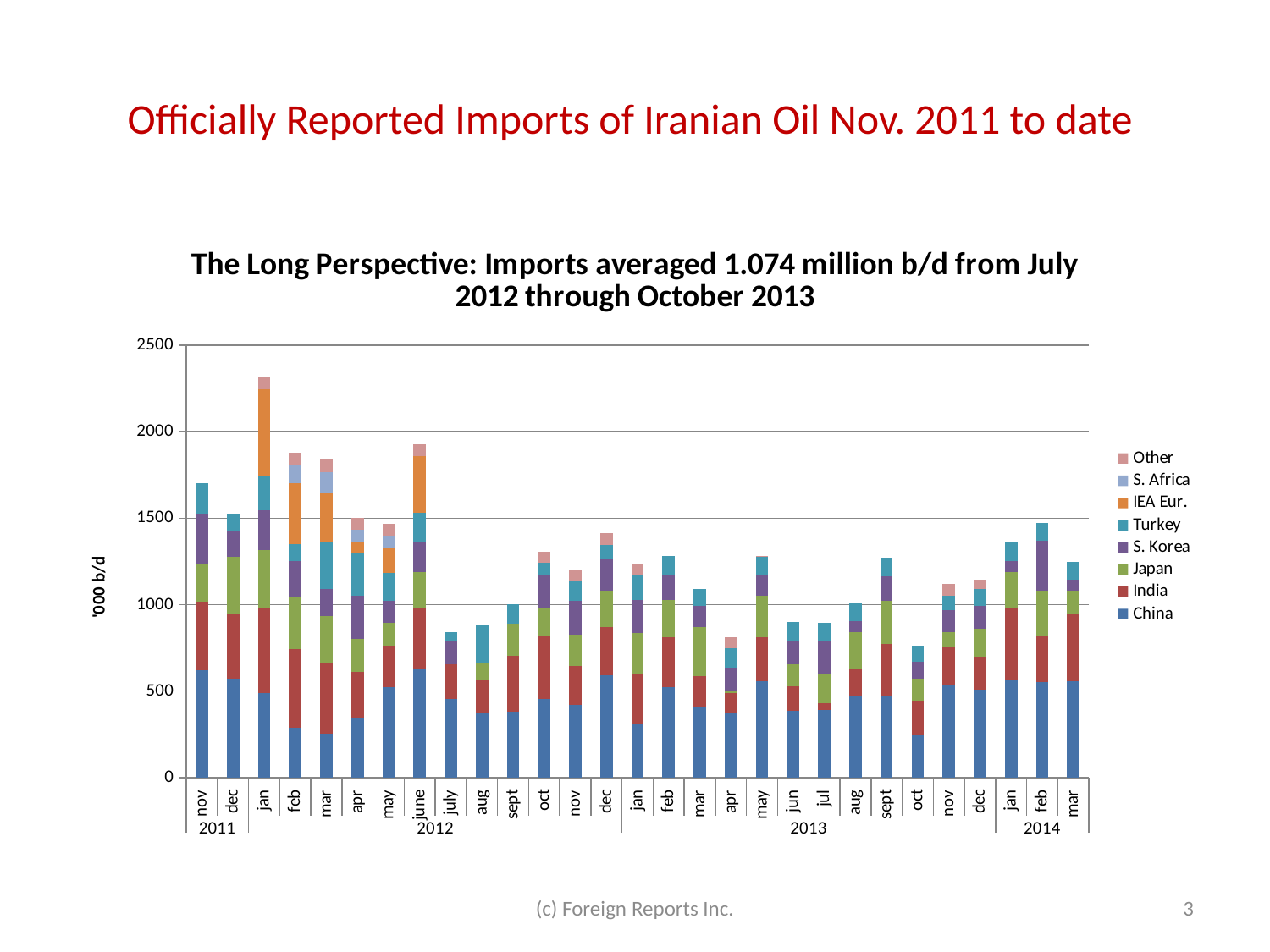
What is the label on the vertical axis? '000 b/d How many monthly bars are plotted in the chart? 29 Do the total bars generally rise or fall from jan 2012 to july 2012? fall Which month has the tallest total bar? jan 2012 How many series does the legend list? 8 What kind of chart is shown on the slide? stacked bar chart Which total bar is larger, jan 2012 or feb 2012? jan 2012 Is the total for jan 2012 greater or less than 2000? greater Is the total for july 2012 greater or less than 1000? less Is the total for feb 2014 greater or less than 1500? less Which series forms the bottom segment of each stacked bar? China